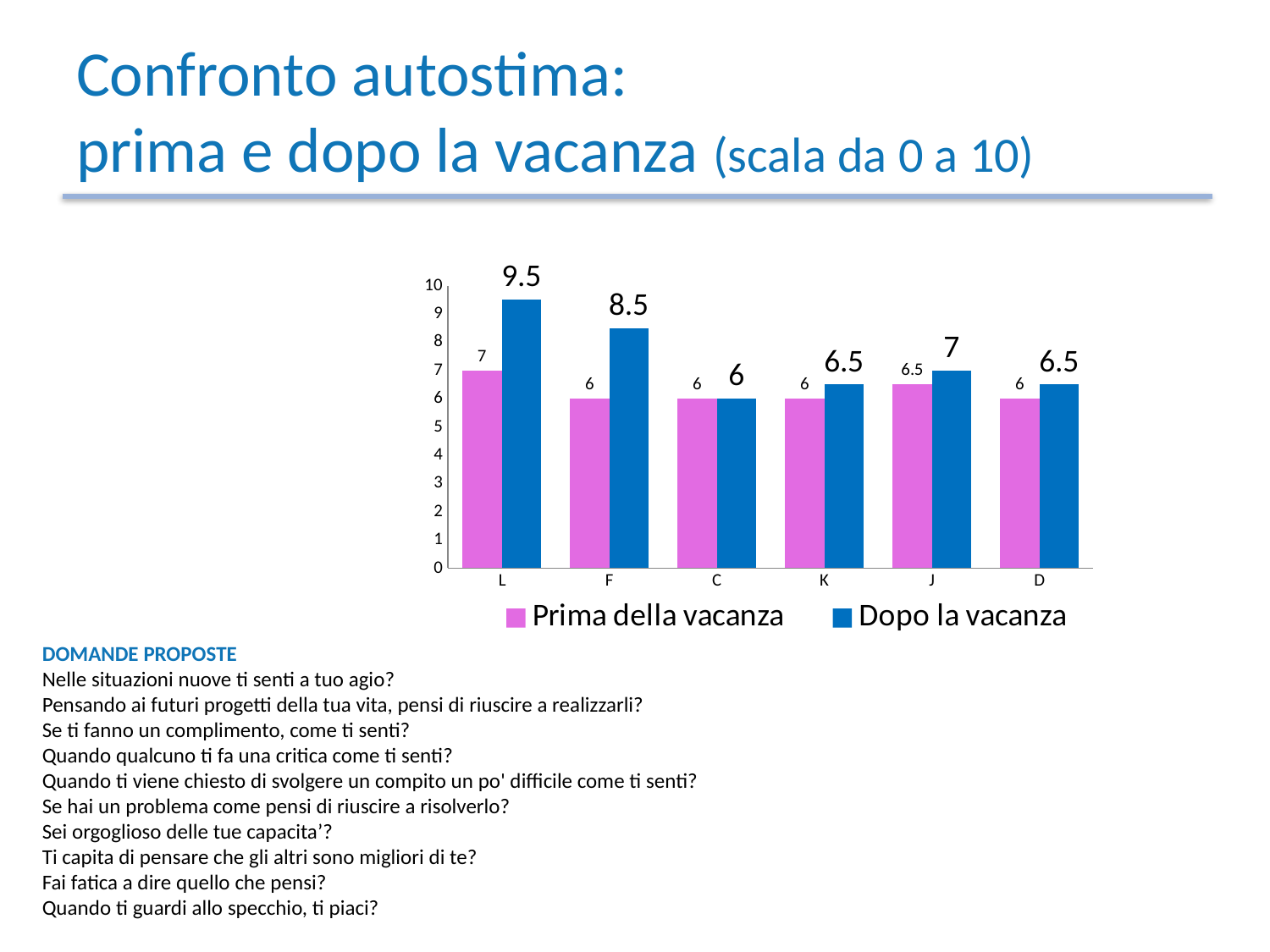
Which colour represents the 'Dopo la vacanza' series? Blue What is the 'Dopo la vacanza' value for F? 8.5 Which category has the highest 'Prima della vacanza' value? L Which category has the highest 'Dopo la vacanza' value? L What is the 'Prima della vacanza' value for J? 6.5 What kind of chart is shown on the slide? Bar chart What is the 'Dopo la vacanza' value for L? 9.5 For K, which is larger: the 'Prima della vacanza' value or the 'Dopo la vacanza' value? Dopo la vacanza What is the difference between the 'Dopo la vacanza' values for L and F? 1 What is the difference between the 'Dopo la vacanza' and 'Prima della vacanza' values for F? 2.5 How many series does the legend list? 2 How many categories are shown on the x axis? 6